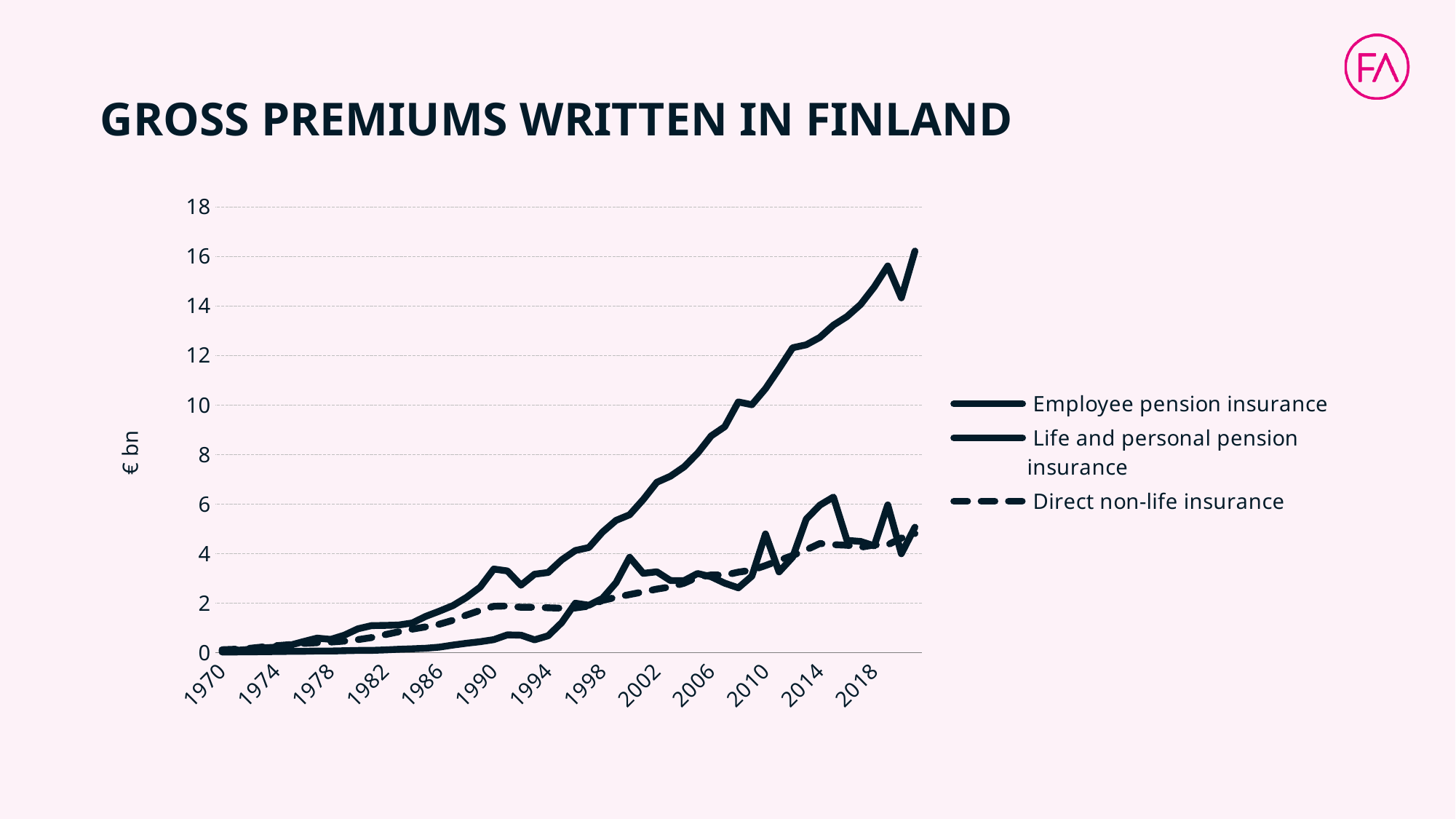
Does the Employee pension insurance series generally rise or fall from 1970 to the end of the chart? Rise In 1990, which is larger: Employee pension insurance or Life and personal pension insurance? Employee pension insurance What is the title of the chart? GROSS PREMIUMS WRITTEN IN FINLAND Is the value for Life and personal pension insurance in 2014 greater or less than 4? greater Is the value for Employee pension insurance in 2018 greater or less than 12? greater What kind of chart is shown on the slide? Line chart How many series does the legend list? 3 Which series has the highest value at the right end of the chart? Employee pension insurance What unit is shown on the y-axis label? € bn Is the value for Direct non-life insurance in 2018 greater or less than 6? less How many year labels are shown on the x-axis? 13